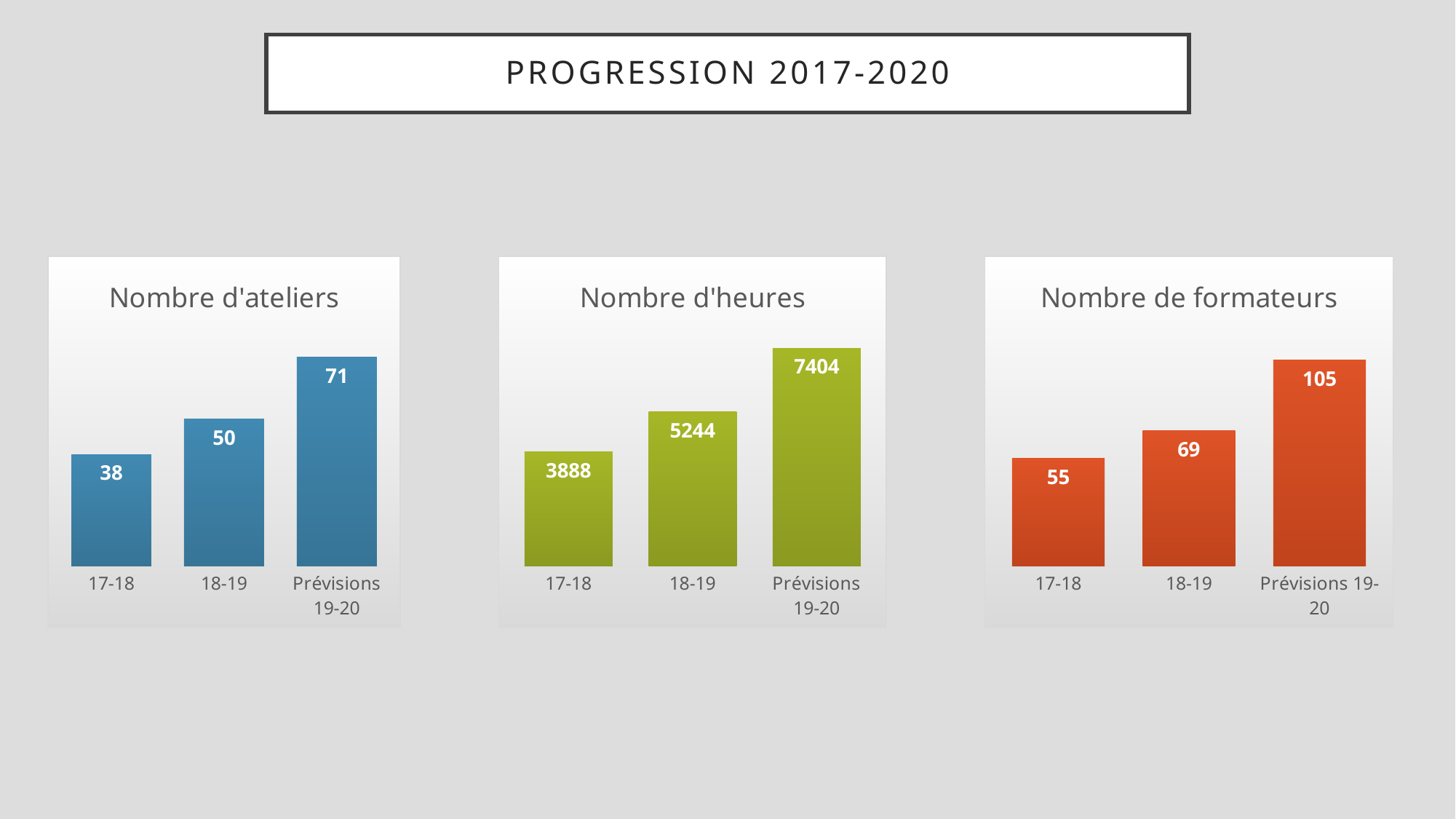
In the "Nombre d'ateliers" chart, what is the difference between the values for Prévisions 19-20 and 17-18? 33 In the "Nombre de formateurs" chart, which category has the highest value? Prévisions 19-20 What kind of chart is the "Nombre d'heures" chart? Bar chart In the "Nombre d'ateliers" chart, what is the value for 18-19? 50 What colour are the bars in the "Nombre d'ateliers" chart? Blue How many categories are shown in the "Nombre d'ateliers" chart? 3 In the "Nombre d'heures" chart, what is the difference between the values for 18-19 and 17-18? 1356 In the "Nombre de formateurs" chart, do the values rise or fall from 17-18 to Prévisions 19-20? Rise In the "Nombre d'heures" chart, what is the value for Prévisions 19-20? 7404 In the "Nombre de formateurs" chart, which is larger, the value for 18-19 or the value for 17-18? 18-19 In the "Nombre de formateurs" chart, what is the value for 17-18? 55 In the "Nombre d'heures" chart, which category has the lowest value? 17-18